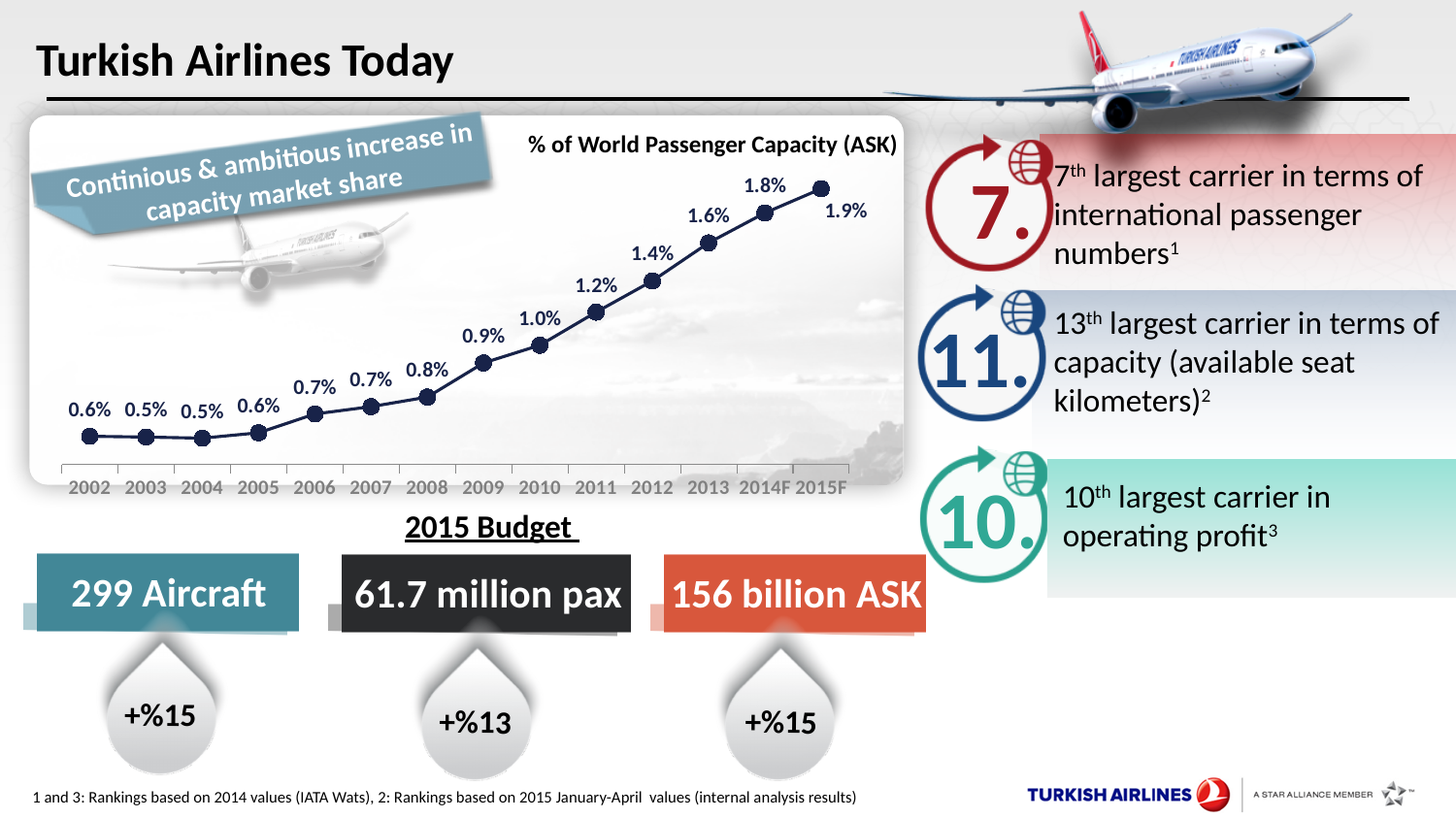
What is the value for 2010 in the % of World Passenger Capacity (ASK) chart? 1.0% What is the value for 2012 in the % of World Passenger Capacity (ASK) chart? 1.4% Which is larger in the % of World Passenger Capacity (ASK) chart, the value for 2008 or the value for 2014F? 2014F Do the values in the % of World Passenger Capacity (ASK) chart generally rise or fall from 2005 to 2015F? Rise What is the value for 2015F in the % of World Passenger Capacity (ASK) chart? 1.9% What is the title of the line chart on the slide? % of World Passenger Capacity (ASK) How many years are plotted in the % of World Passenger Capacity (ASK) chart? 14 What is the difference between the 2015F and 2002 values in the % of World Passenger Capacity (ASK) chart? 1.3% What kind of chart is the % of World Passenger Capacity (ASK) chart? Line chart Which year has the highest value in the % of World Passenger Capacity (ASK) chart? 2015F What is the value for 2002 in the % of World Passenger Capacity (ASK) chart? 0.6% What is the difference between the 2013 and 2011 values in the % of World Passenger Capacity (ASK) chart? 0.4%